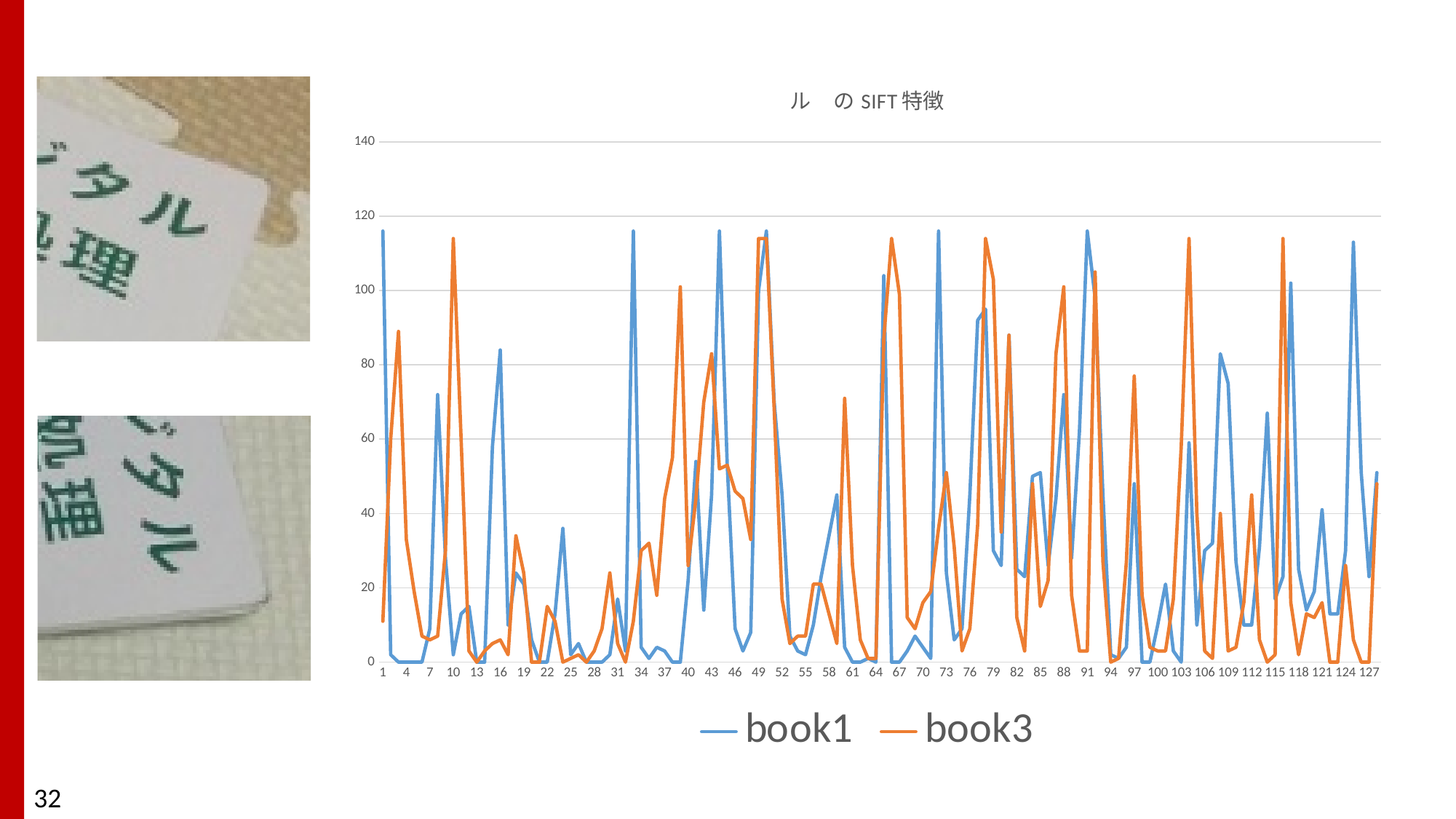
Is the value for book3 at x = 10 greater or less than 100? greater How many series does the legend list? 2 Is the value for book3 at x = 1 greater or less than 20? less What are the two series named in the legend? book1 and book3 What kind of chart is shown on the slide? line chart Is the value for book1 at x = 16 greater or less than 60? greater Which colour is used for the book3 series? orange